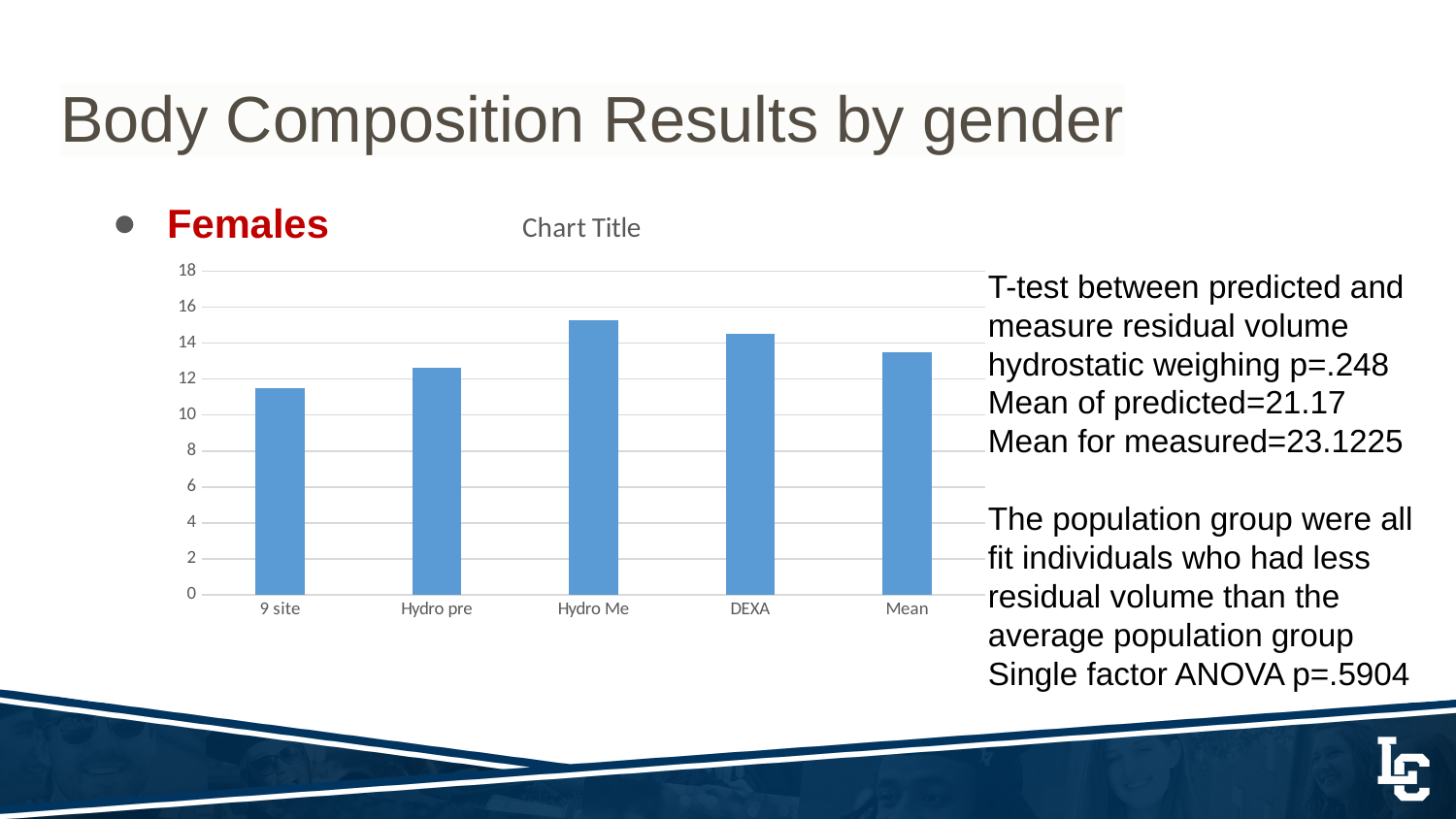
Which category has the highest bar in the chart? Hydro Me What kind of chart is shown on the slide? bar chart Is the value for DEXA greater or less than 12? greater Is the value for Hydro pre greater or less than 14? less Is the value for 9 site greater or less than 10? greater What colour are the bars in the chart? blue Which category has the lowest bar in the chart? 9 site What is the title shown above the chart? Chart Title How many categories are shown on the x axis of the chart? 5 Which is larger, the value for DEXA or the value for Hydro pre? DEXA Which is larger, the value for Hydro Me or the value for 9 site? Hydro Me